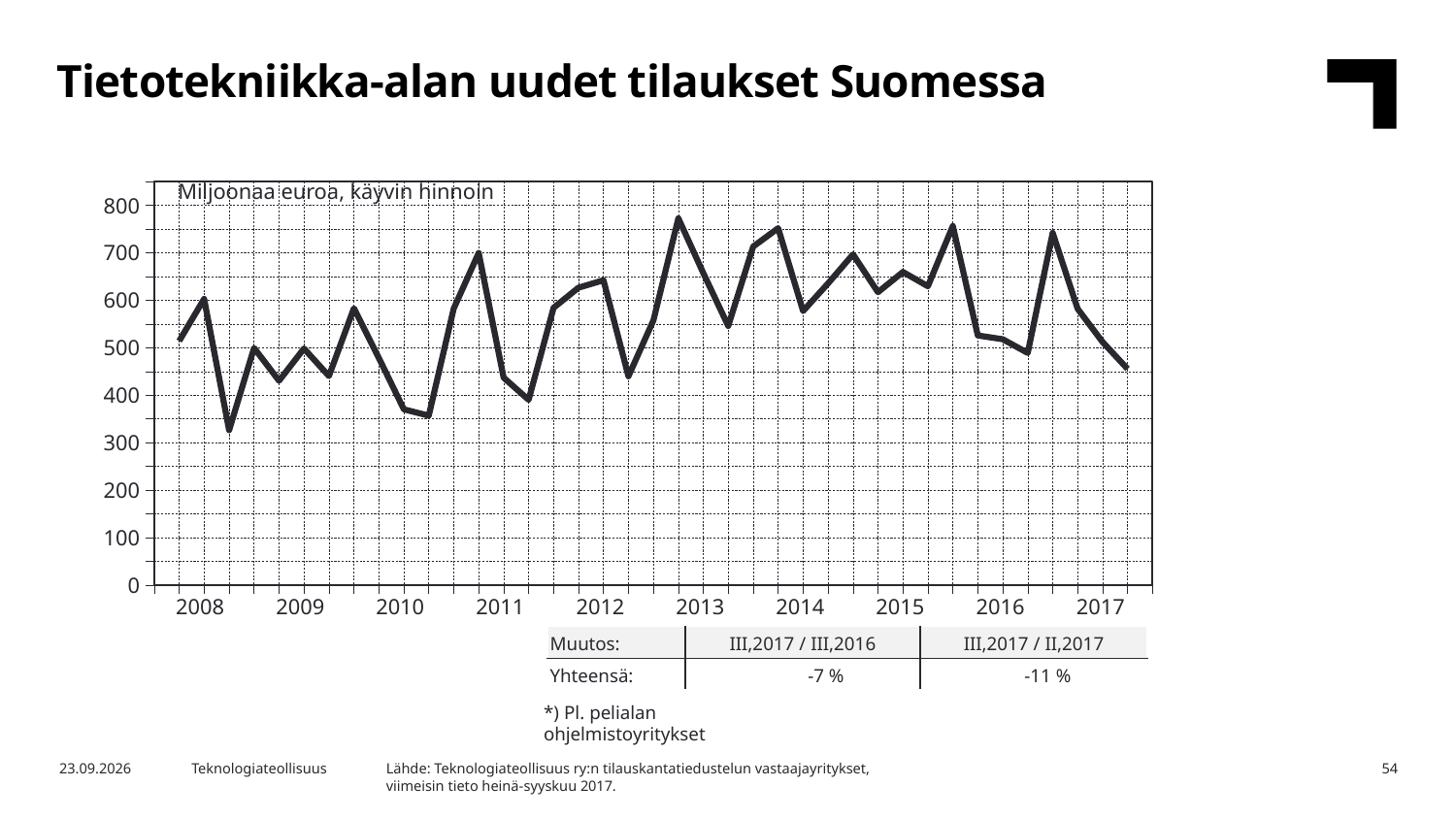
What is the title of the slide's chart? Tietotekniikka-alan uudet tilaukset Suomessa Is the last point of the line in 2017 greater or less than 500? less What kind of chart is shown on the slide? line chart According to the table below the chart, what is the change for III,2017 / II,2017? -11 % How many year labels are shown on the x axis? 10 Does the line rise or fall from the 2016 peak to the last point in 2017? fall Is the peak of the line in 2016 greater or less than 700? greater Is the lowest point of the line in 2008 greater or less than 400? less What is the highest value shown on the y axis? 800 What unit is stated in the label at the top of the chart? Miljoonaa euroa, käyvin hinnoin